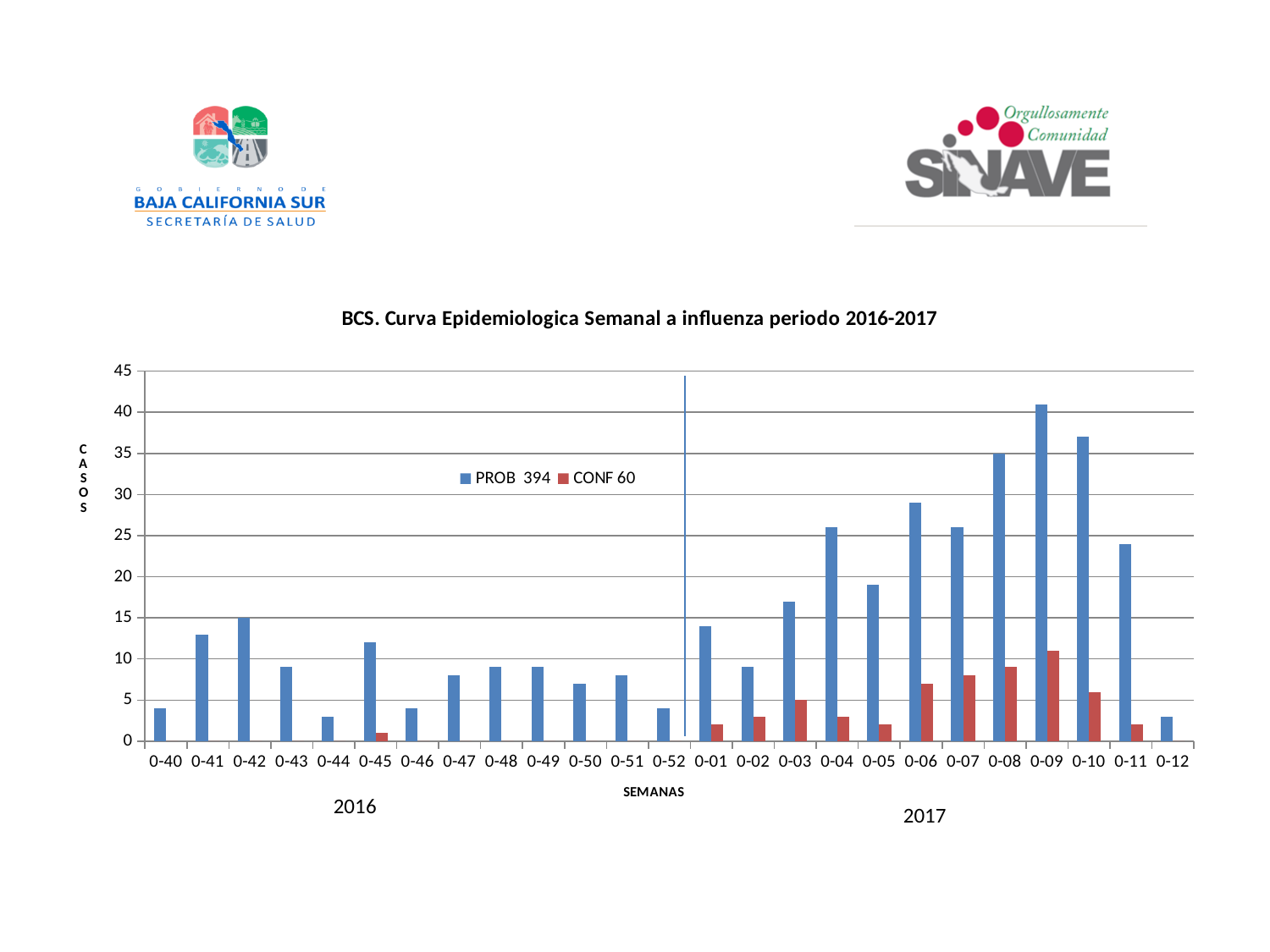
Which is larger, the PROB value for week 0-42 or for week 0-43? 0-42 How many series does the legend list? 2 What kind of chart is shown on the slide? bar chart Which week has the highest CONF value? 0-09 How many weeks (categories) are shown on the x axis? 25 Is the PROB value for week 0-06 greater or less than 30? less What is the title of the chart? BCS. Curva Epidemiologica Semanal a influenza periodo 2016-2017 Is the PROB value for week 0-09 greater or less than 40? greater Which week has the highest PROB value? 0-09 From week 0-09 to week 0-12, do the PROB values rise or fall? fall Is the CONF value for week 0-09 greater or less than 10? greater What are the two series named in the legend? PROB 394 and CONF 60